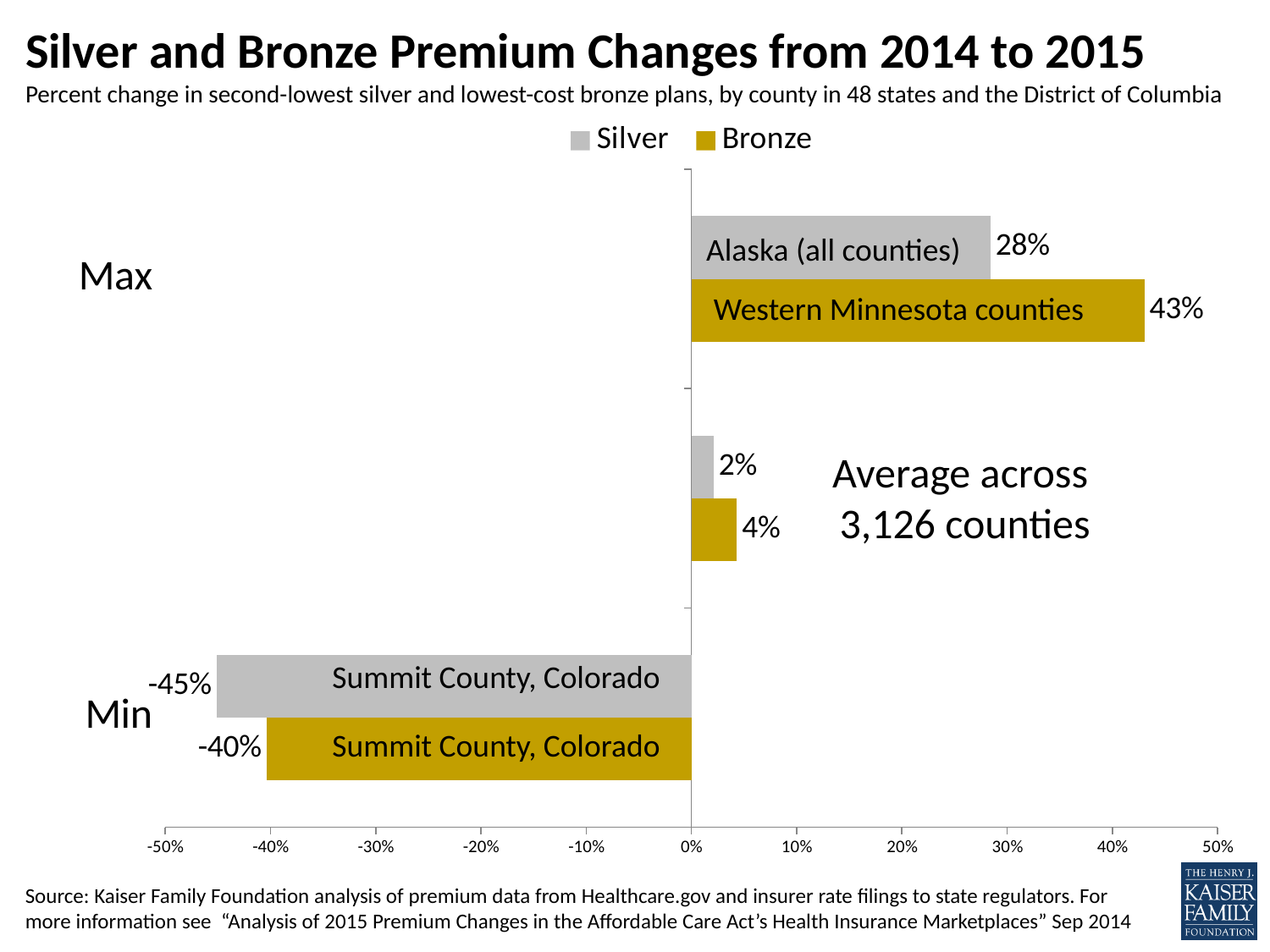
Which county is labelled on the Min bars? Summit County, Colorado What is the Bronze value for Min? -40% What is the Silver value for Max? 28% What is the difference between the Silver and Bronze Min values? 5 percentage points What kind of chart is shown on the slide? Bar chart What is the Silver value for the average across 3,126 counties? 2% What is the Bronze value for Max? 43% Which series has the higher Max value, Silver or Bronze? Bronze Which area is labelled on the Bronze Max bar? Western Minnesota counties What is the Silver value for Min? -45% What is the difference between the Bronze and Silver Max values? 15 percentage points How many series does the legend list? 2